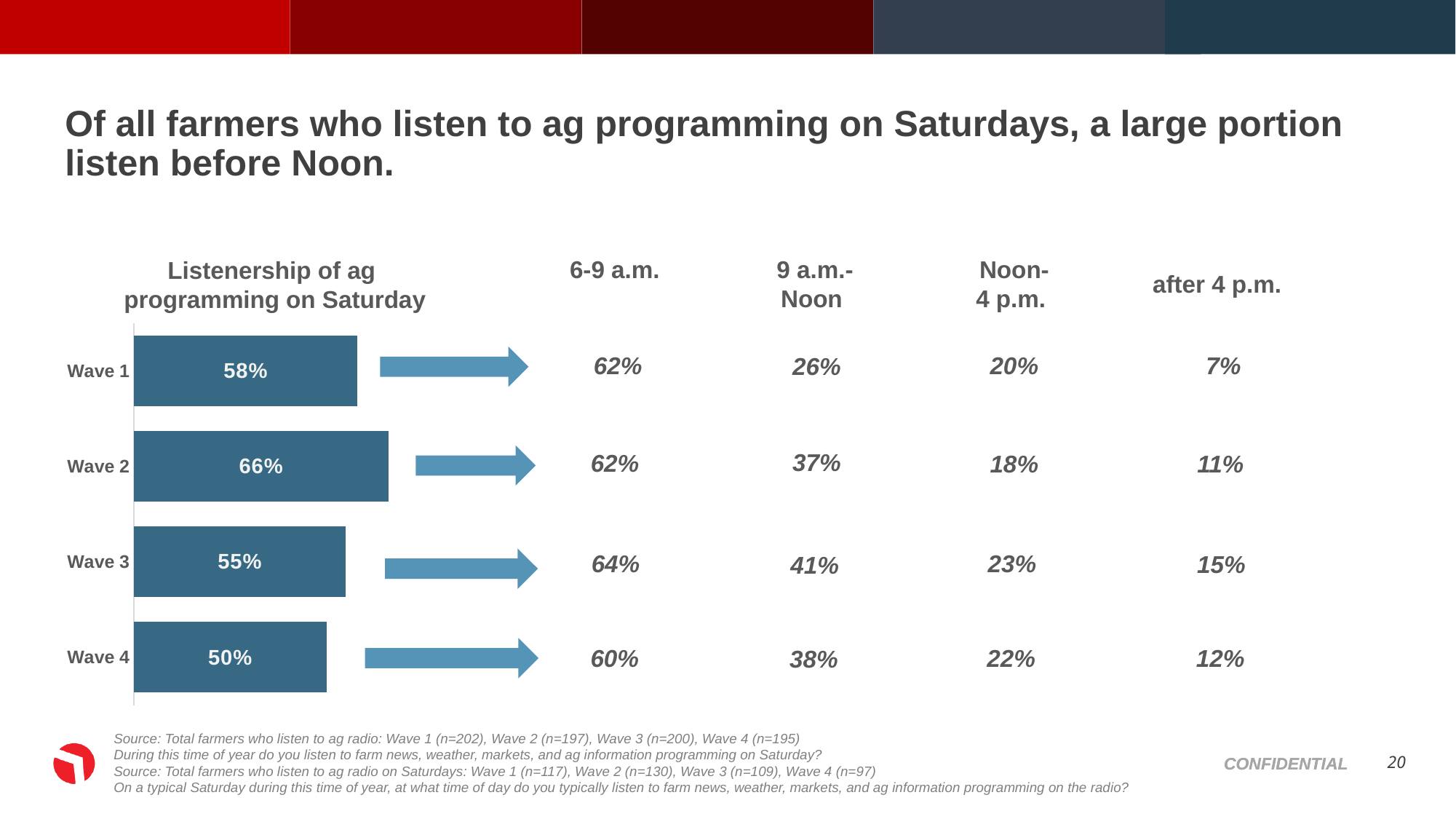
What is the value for Wave 4 in the 'Listenership of ag programming on Saturday' chart? 50% What is the value for Wave 2 in the 'Listenership of ag programming on Saturday' chart? 66% What is the title of the bar chart on the slide? Listenership of ag programming on Saturday What kind of chart is 'Listenership of ag programming on Saturday'? Bar chart In the 'Listenership of ag programming on Saturday' chart, which is larger, Wave 1 or Wave 3? Wave 1 In the 'Listenership of ag programming on Saturday' chart, what is the difference between Wave 1 and Wave 3? 3% How many waves are shown in the 'Listenership of ag programming on Saturday' chart? 4 Are the bars in the 'Listenership of ag programming on Saturday' chart horizontal or vertical? Horizontal Which wave has the highest value in the 'Listenership of ag programming on Saturday' chart? Wave 2 Which wave has the lowest value in the 'Listenership of ag programming on Saturday' chart? Wave 4 In the 'Listenership of ag programming on Saturday' chart, do the values rise or fall from Wave 2 to Wave 4? Fall In the 'Listenership of ag programming on Saturday' chart, what is the difference between Wave 2 and Wave 4? 16%